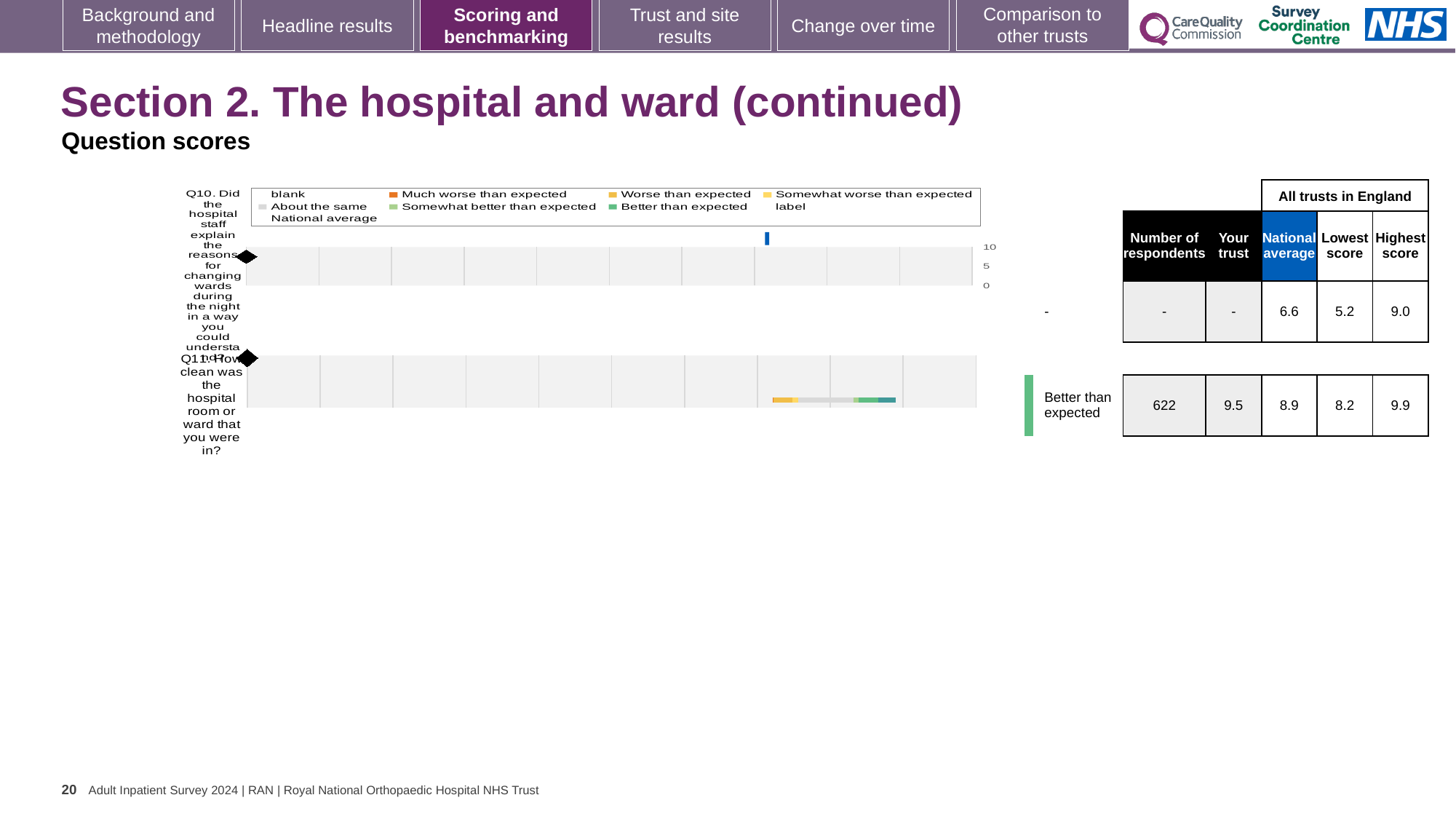
What kind of chart is shown on the slide? bar chart What is the lowest score across all trusts in England for Q10? 5.2 Which is larger for Q11: the 'Your trust' score or the national average? Your trust What benchmark category is shown for Q11? Better than expected What is the number of respondents for Q11? 622 What is the highest score across all trusts in England for Q11? 9.9 What is the national average score for Q10? 6.6 What is the difference between the highest and lowest scores for Q11? 1.7 What is the national average score for Q11? 8.9 What is the maximum value shown on the chart's score axis? 10 What is the 'Your trust' score for Q11 (How clean was the hospital room or ward that you were in?)? 9.5 How many questions (categories) are plotted on the chart? 2